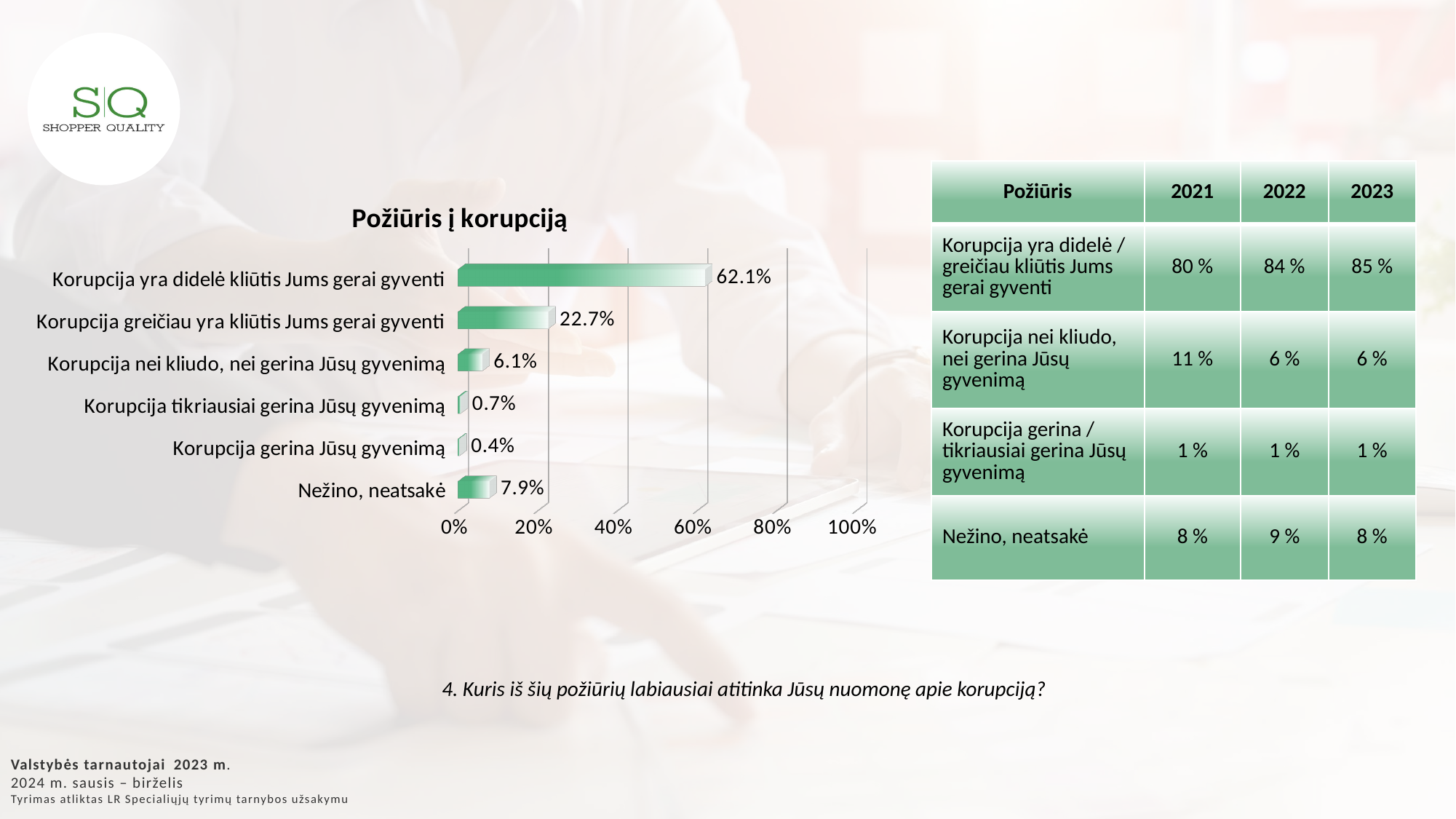
Which category has the highest value in the chart? Korupcija yra didelė kliūtis Jums gerai gyventi Which category has the lowest value in the chart? Korupcija gerina Jūsų gyvenimą What is the title of the chart? Požiūris į korupciją Which is larger: the value for "Nežino, neatsakė" or the value for "Korupcija nei kliudo, nei gerina Jūsų gyvenimą"? Nežino, neatsakė Is the value for "Korupcija yra didelė kliūtis Jums gerai gyventi" greater or less than 60%? greater What is the value for "Korupcija greičiau yra kliūtis Jums gerai gyventi" in the chart? 22.7% What is the difference between the values for "Korupcija yra didelė kliūtis Jums gerai gyventi" and "Korupcija greičiau yra kliūtis Jums gerai gyventi"? 39.4% What kind of chart is shown on the slide? bar chart How many categories are shown in the chart? 6 What is the value for "Korupcija yra didelė kliūtis Jums gerai gyventi" in the chart? 62.1% What is the value for "Korupcija tikriausiai gerina Jūsų gyvenimą" in the chart? 0.7% What is the value for "Nežino, neatsakė" in the chart? 7.9%